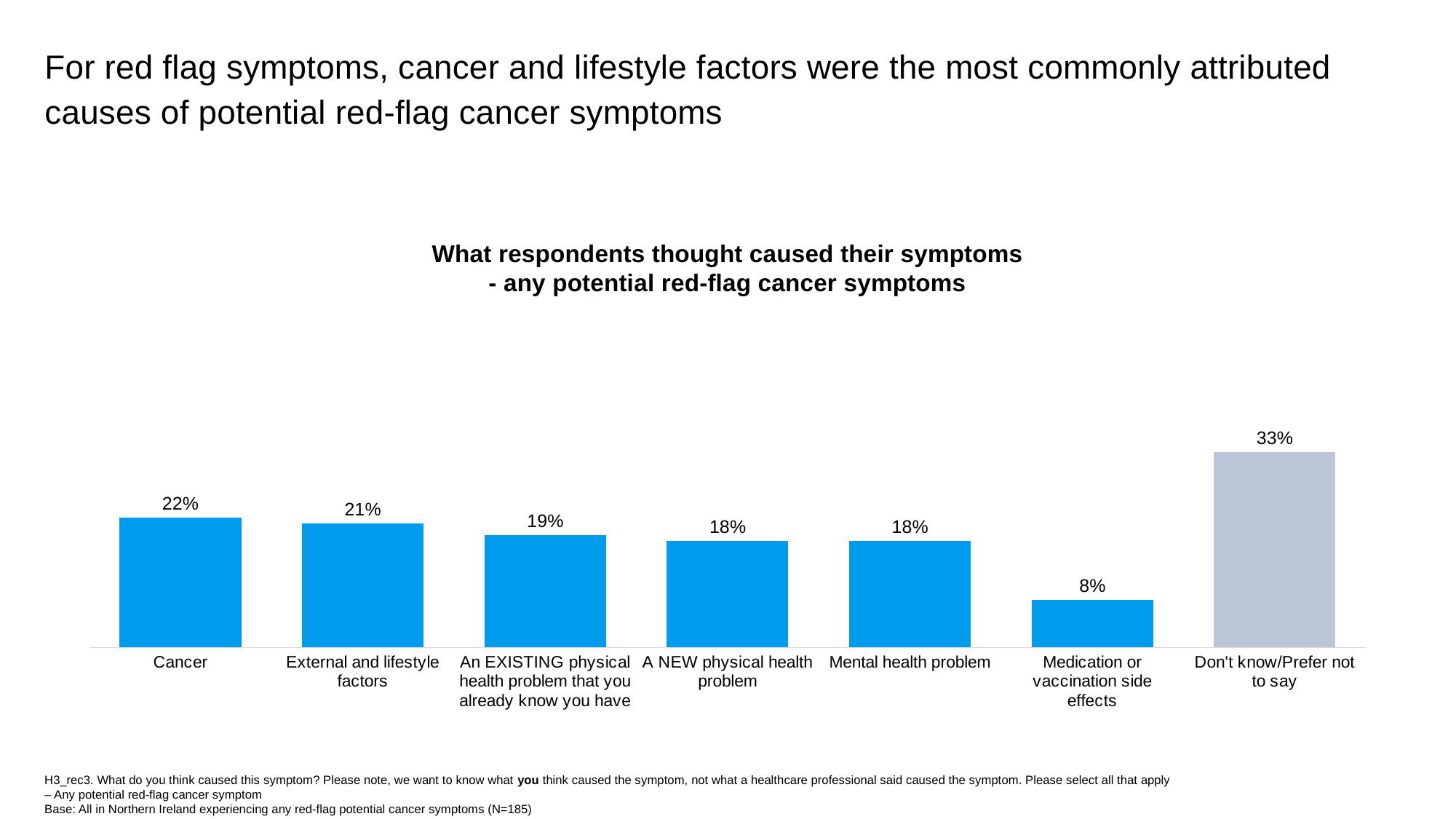
What is the value for 'Medication or vaccination side effects'? 8% What is the value for 'Don't know/Prefer not to say'? 33% What is the value for 'External and lifestyle factors'? 21% What percentage of respondents attributed their symptoms to cancer? 22% What is the difference between 'Don't know/Prefer not to say' and 'Cancer'? 11% Which category has the highest value? Don't know/Prefer not to say What type of chart is shown on the slide? Bar chart Which is larger: the value for 'Cancer' or the value for 'Mental health problem'? Cancer Which bar is shown in a different colour (grey) from the others? Don't know/Prefer not to say What is the difference between the values for 'Cancer' and 'Medication or vaccination side effects'? 14% Which category has the lowest value? Medication or vaccination side effects How many categories are shown in the chart? 7